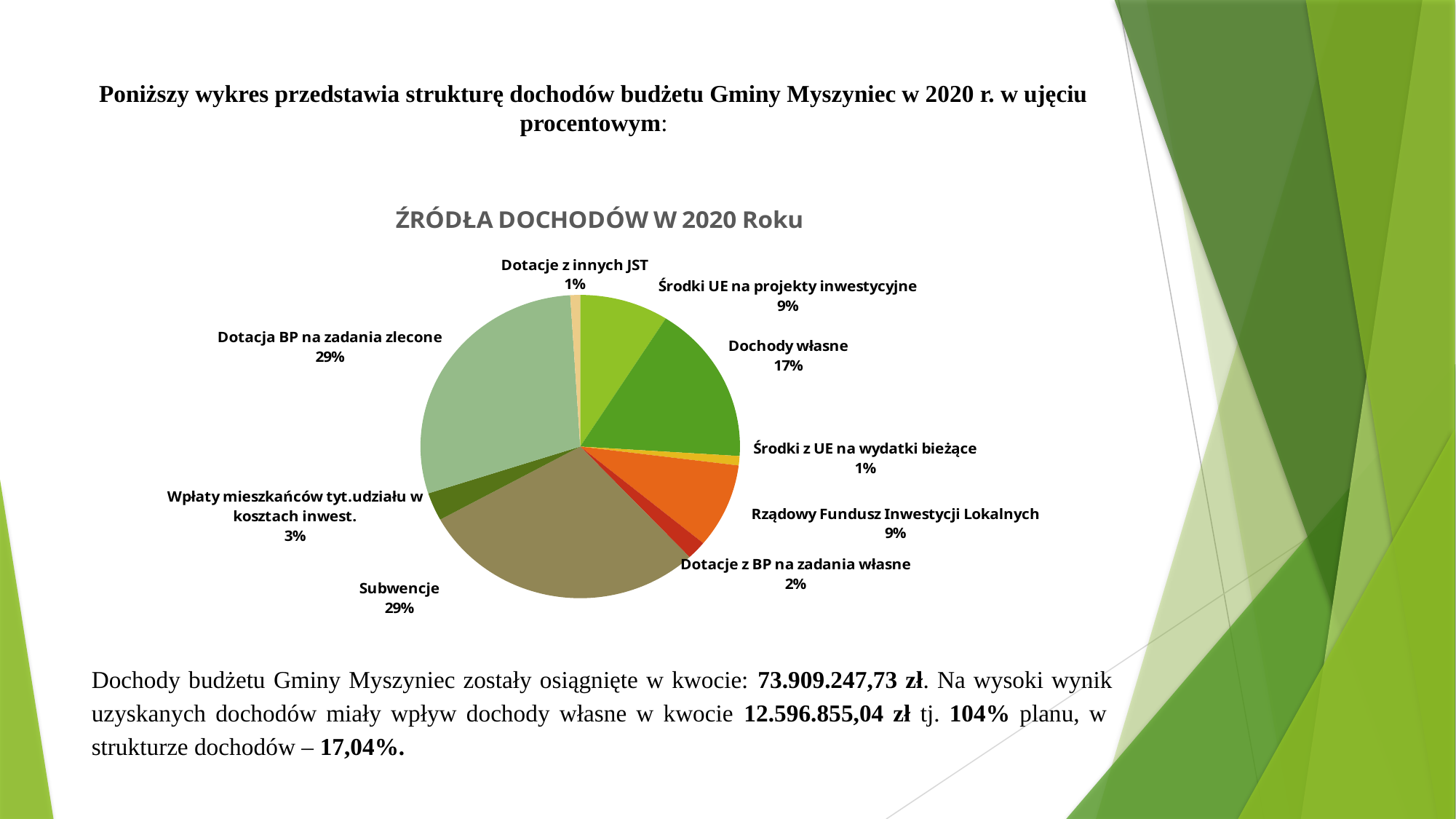
What share of the pie is Dotacja BP na zadania zlecone? 29% What share of the pie is Subwencje? 29% What share of the pie is Dochody własne? 17% What is the difference between the shares of Subwencje and Dochody własne? 12 percentage points What kind of chart is shown on the slide? pie chart What is the value shown for Wpłaty mieszkańców tyt.udziału w kosztach inwest.? 3% What is the value shown for Środki UE na projekty inwestycyjne? 9% Which is larger, Rządowy Fundusz Inwestycji Lokalnych or Dotacje z innych JST? Rządowy Fundusz Inwestycji Lokalnych Which is larger, Dochody własne or Subwencje? Subwencje How many slices does the pie chart have? 9 What is the title of the chart? ŹRÓDŁA DOCHODÓW W 2020 Roku What is the value shown for Dotacje z BP na zadania własne? 2%